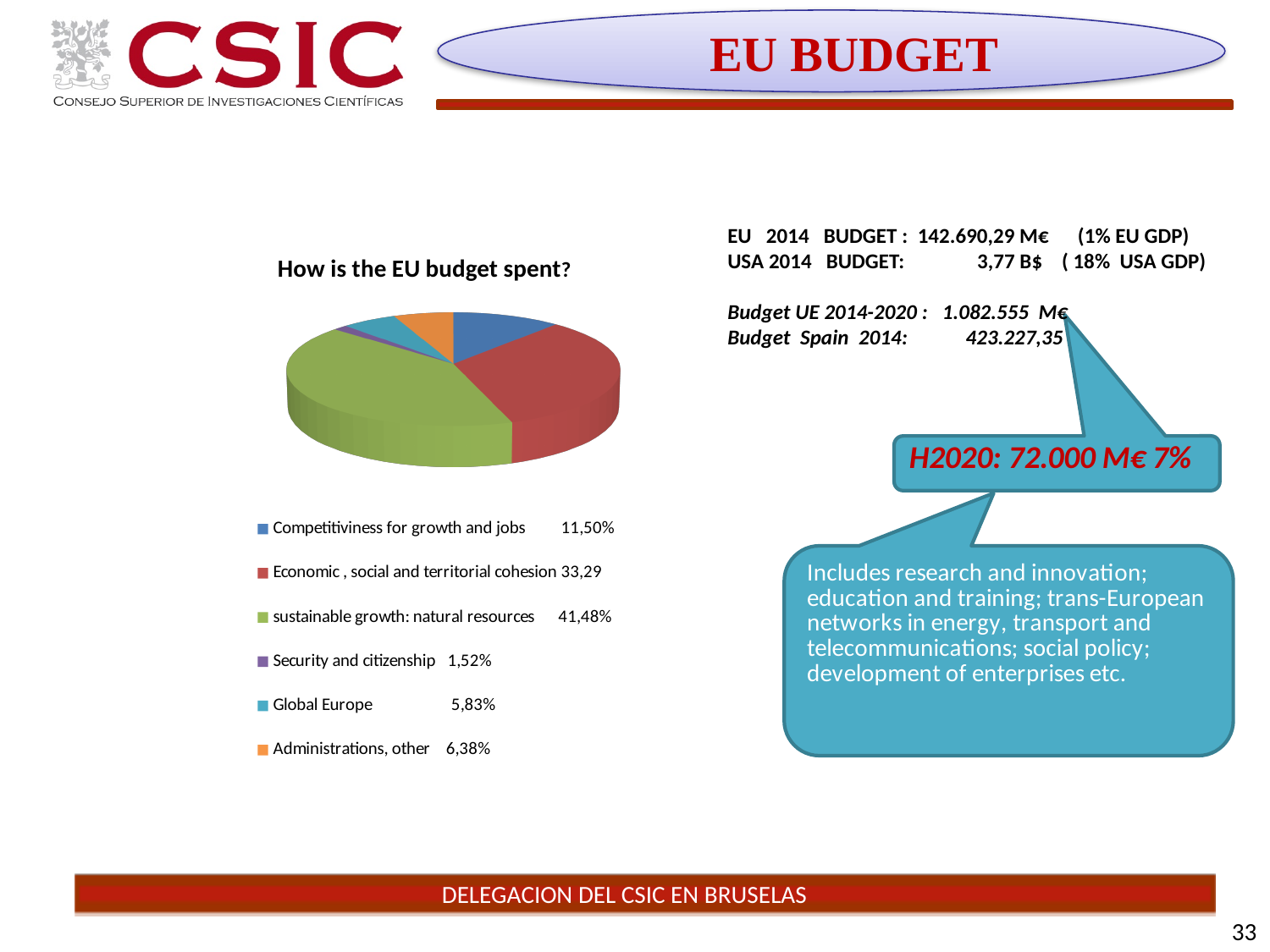
How many categories does the pie chart have? 6 What value is shown for Security and citizenship? 1,52% What value is shown for Administrations, other? 6,38% Which category has the largest share of the EU budget? sustainable growth: natural resources Which category has the smallest share of the EU budget? Security and citizenship What kind of chart is shown on the slide? pie chart Which is larger, the share for Global Europe or the share for Administrations, other? Administrations, other What value is shown for Global Europe? 5,83% What colour is the slice for sustainable growth: natural resources? green What is the title of the chart? How is the EU budget spent? What share of the EU budget goes to sustainable growth: natural resources? 41,48% What share of the EU budget goes to Competitiveness for growth and jobs? 11,50%